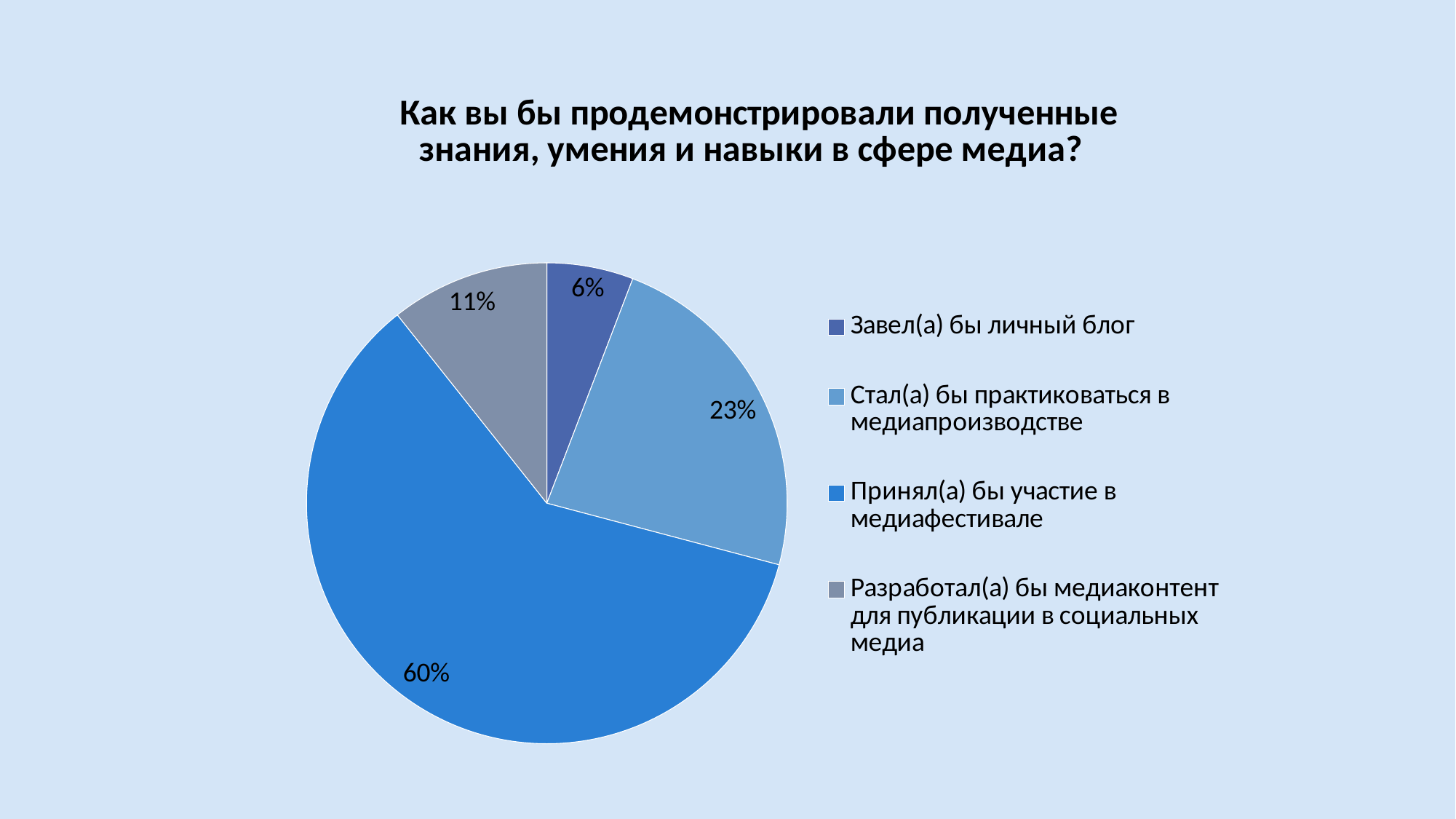
What kind of chart is shown on the slide? pie chart Which category has the largest slice of the pie? Принял(а) бы участие в медиафестивале What share of the pie is labelled for "Принял(а) бы участие в медиафестивале"? 60% Which category has the smallest slice of the pie? Завел(а) бы личный блог What is the title of the chart? Как вы бы продемонстрировали полученные знания, умения и навыки в сфере медиа? What is the difference in percentage points between "Принял(а) бы участие в медиафестивале" and "Стал(а) бы практиковаться в медиапроизводстве"? 37% What share of the pie is labelled for "Завел(а) бы личный блог"? 6% How many categories does the pie chart have? 4 Which is larger: the slice for "Стал(а) бы практиковаться в медиапроизводстве" or the slice for "Разработал(а) бы медиаконтент для публикации в социальных медиа"? Стал(а) бы практиковаться в медиапроизводстве What share of the pie is labelled for "Стал(а) бы практиковаться в медиапроизводстве"? 23% What is the difference in percentage points between "Разработал(а) бы медиаконтент для публикации в социальных медиа" and "Завел(а) бы личный блог"? 5%